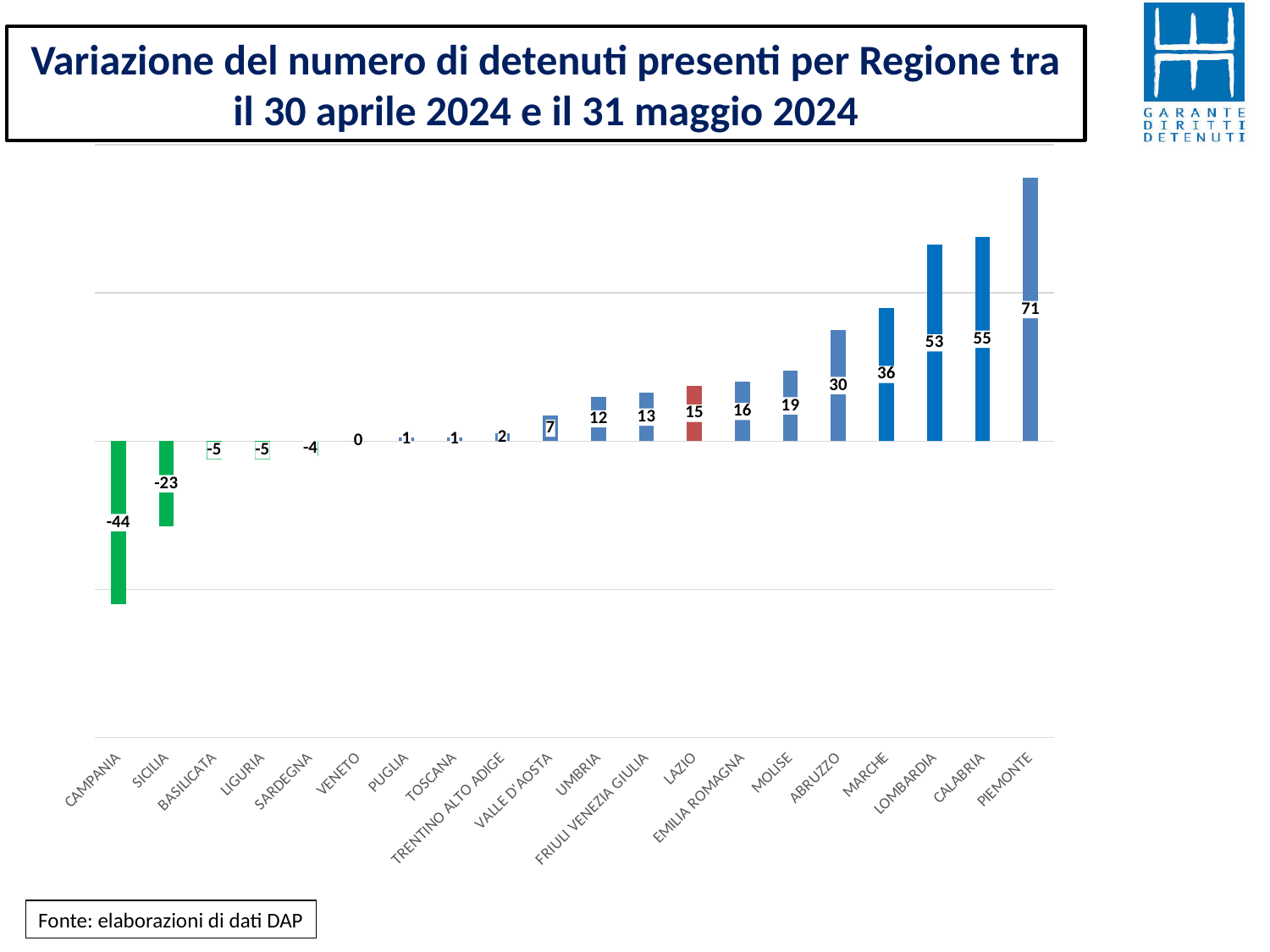
Which region has the lowest value? Campania Which is larger, the value for Molise or the value for Emilia Romagna? Molise What is the value for Lazio? 15 What kind of chart is shown on the slide? Bar chart What is the difference between the values for Calabria and Lombardia? 2 How many regions are shown on the chart? 20 What is the difference between the values for Marche and Abruzzo? 6 What is the value for Sicilia? -23 What is the value for Campania? -44 What is the value for Piemonte? 71 Which region has the highest value? Piemonte Do the values rise or fall from left to right along the x axis? Rise